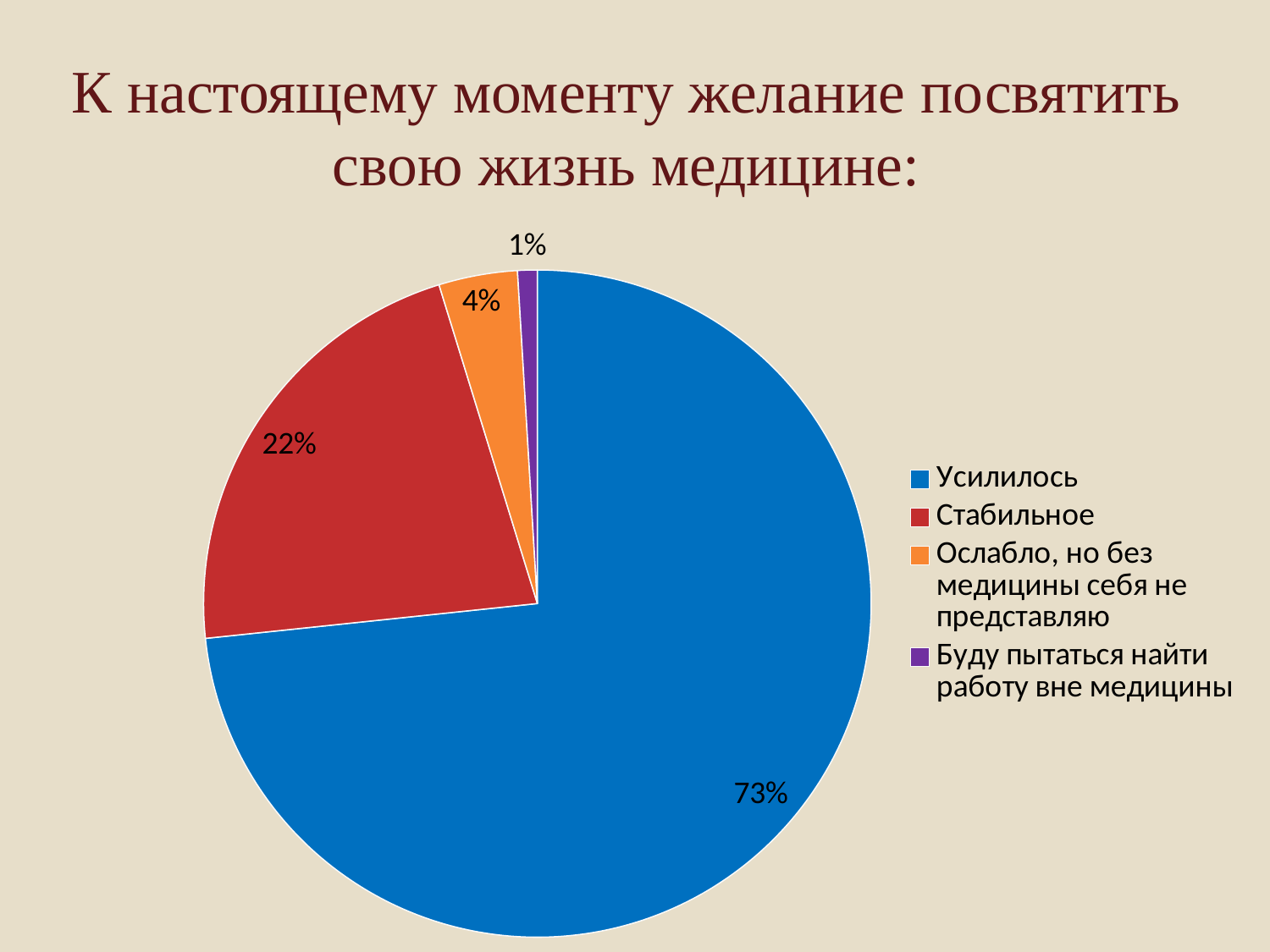
Which category has the largest slice of the pie? Усилилось What is the difference in percentage points between "Усилилось" and "Стабильное"? 51 Which category has the smallest slice of the pie? Буду пытаться найти работу вне медицины What share of the pie does "Стабильное" take? 22% What is the title of the slide above the chart? К настоящему моменту желание посвятить свою жизнь медицине: What share of the pie does "Буду пытаться найти работу вне медицины" take? 1% What share of the pie does "Ослабло, но без медицины себя не представляю" take? 4% What kind of chart is shown on the slide? pie chart How many categories does the pie chart have? 4 Which is larger: the slice for "Стабильное" or the slice for "Ослабло, но без медицины себя не представляю"? Стабильное What colour is the slice for "Стабильное"? red